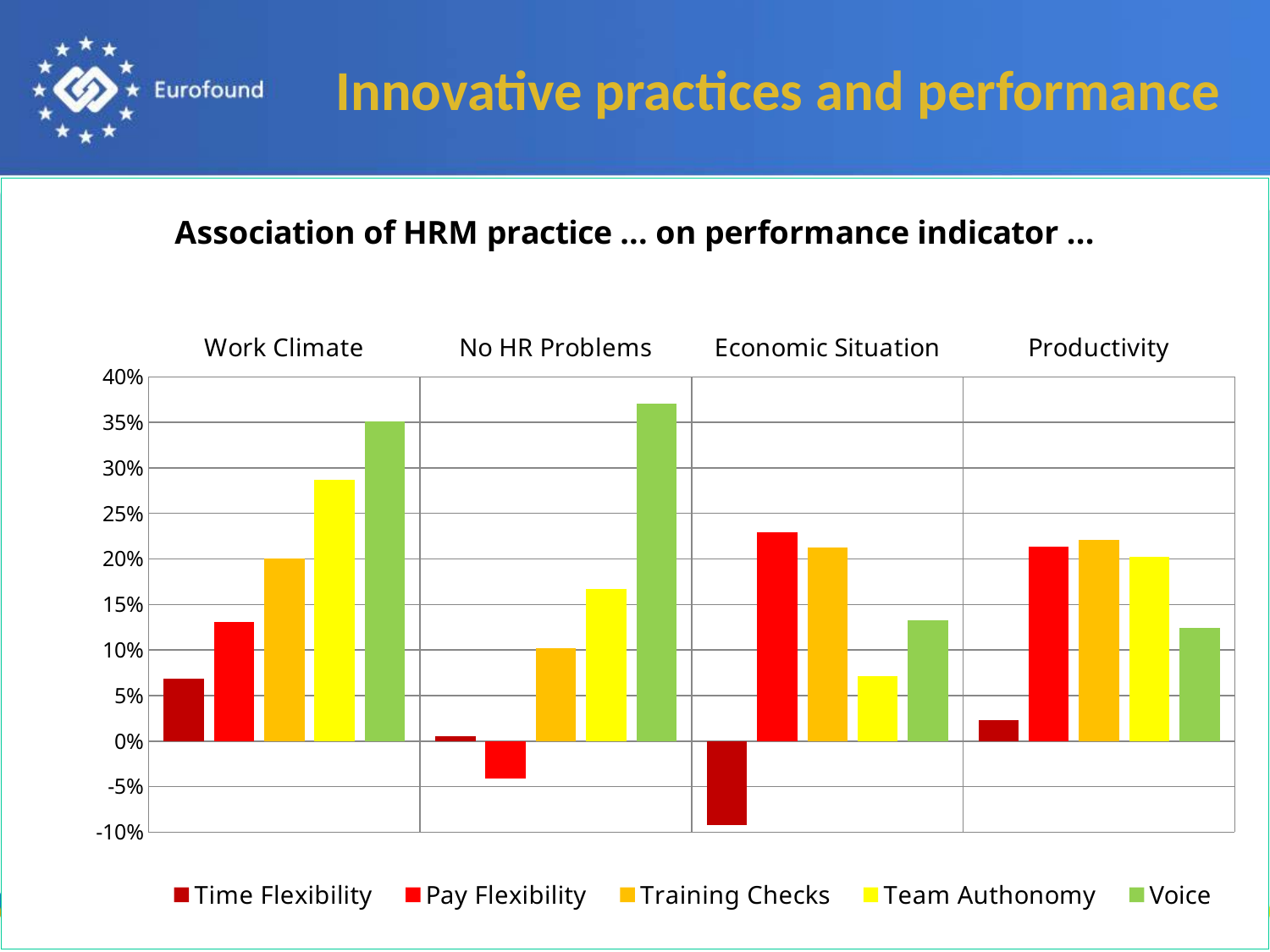
For Work Climate, which is larger: Team Authonomy or Pay Flexibility? Team Authonomy How many series does the legend list? 5 How many performance indicator categories are shown along the x axis? 4 For Economic Situation, which is larger: Pay Flexibility or Team Authonomy? Pay Flexibility What colour represents Voice in the legend? green Is the value for Pay Flexibility under No HR Problems greater or less than 0%? less What kind of chart is shown on the slide? bar chart For Economic Situation, which HRM practice has the lowest bar? Time Flexibility For Work Climate, which HRM practice has the highest bar? Voice Is the value for Time Flexibility under Economic Situation greater or less than -5%? less Is the value for Voice under No HR Problems greater or less than 35%? greater Within the Work Climate group, do the bars rise or fall from Time Flexibility to Voice? rise